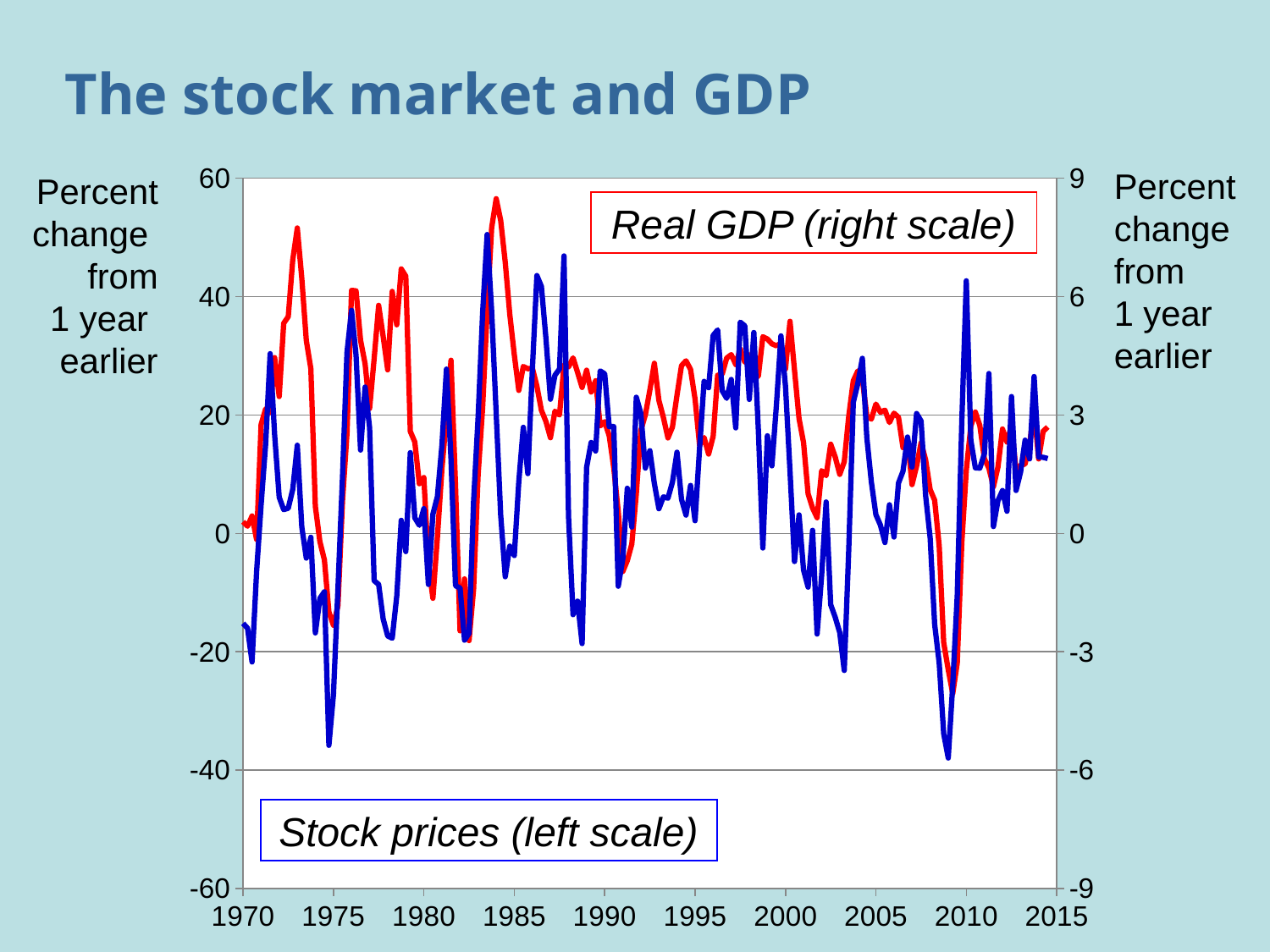
Is the peak value of the Stock prices series around 2010 greater or less than 20? greater Which series is plotted against the right scale? Real GDP Is the peak value of the Real GDP series around 1984 greater or less than 6? greater What kind of chart is shown on the slide? line chart Is the peak value of the Stock prices series around 1983 greater or less than 40? greater How many data series are plotted on the chart? 2 What is the title of the slide's chart? The stock market and GDP